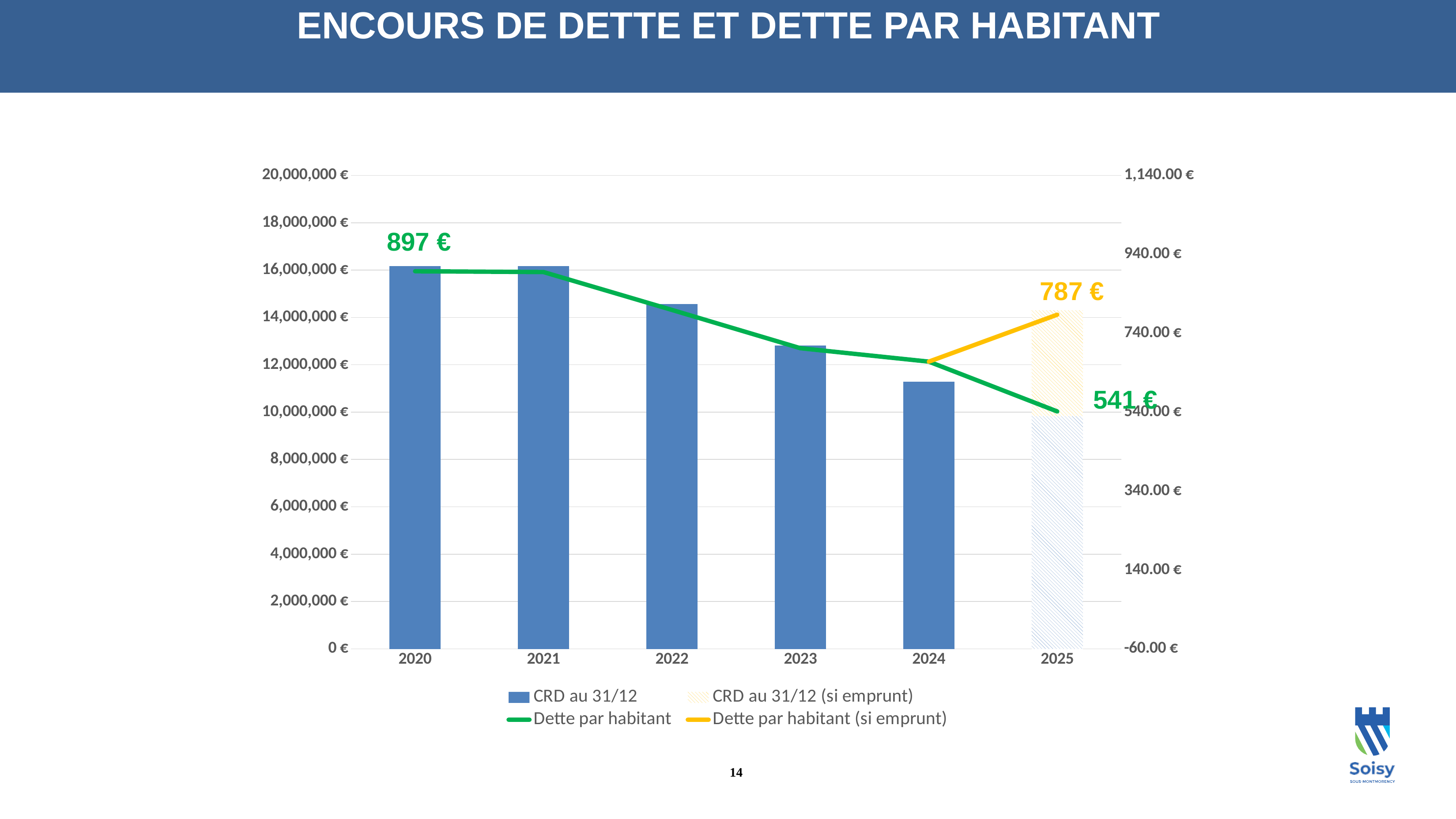
How many years are shown on the x axis? 6 What is the value of Dette par habitant for 2025? 541 € What is the difference between Dette par habitant (si emprunt) and Dette par habitant in 2025? 246 € Do the CRD au 31/12 bars rise or fall from 2020 to 2024? fall What is the value of Dette par habitant for 2020? 897 € Is the CRD au 31/12 value for 2022 greater or less than 14,000,000 €? greater What is the difference between Dette par habitant in 2020 and in 2025? 356 € How many series does the legend list? 4 What is the value of Dette par habitant (si emprunt) for 2025? 787 € Is the CRD au 31/12 value for 2024 greater or less than 12,000,000 €? less In 2025, which is larger: Dette par habitant or Dette par habitant (si emprunt)? Dette par habitant (si emprunt)